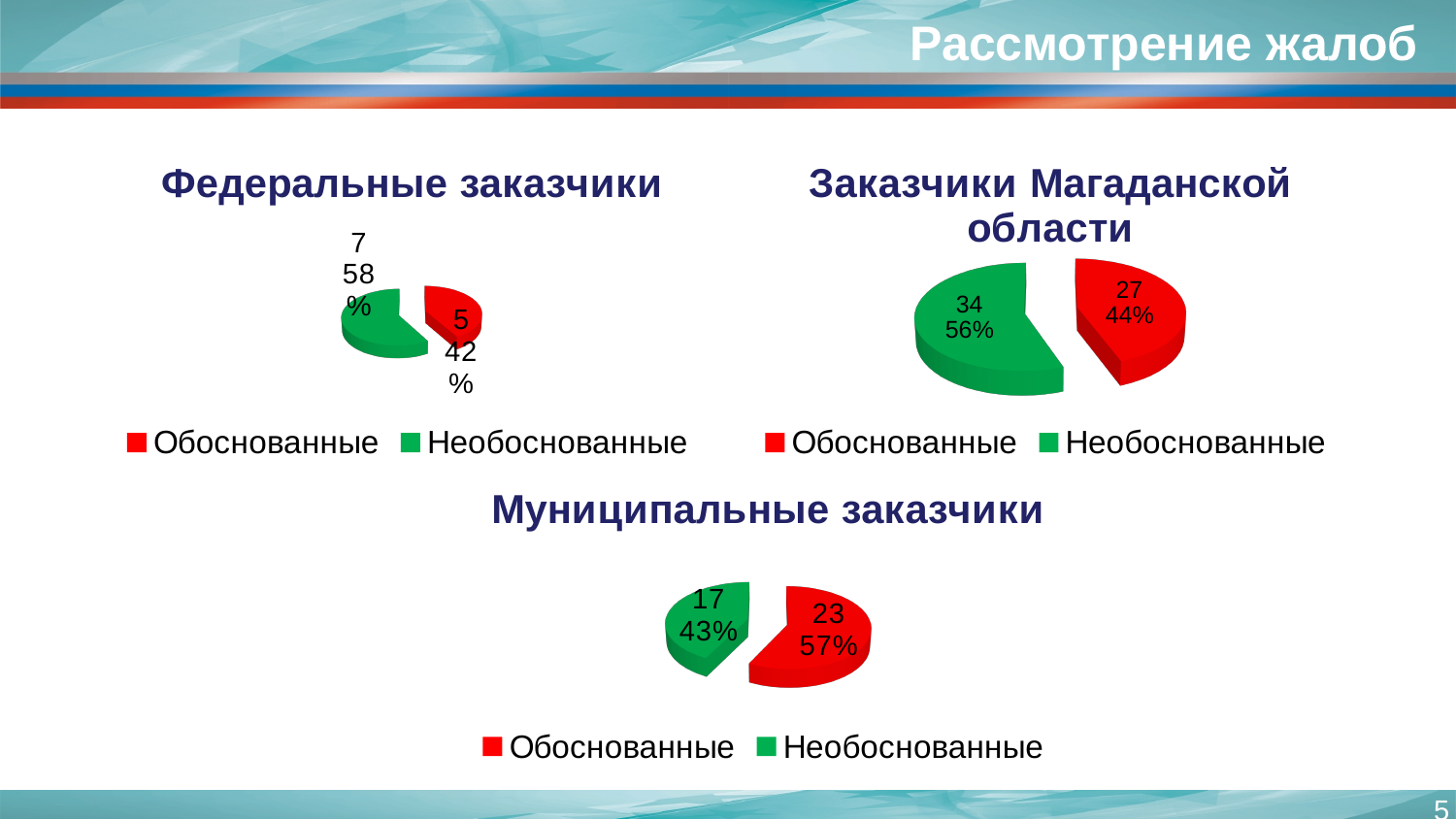
What kind of chart is 'Муниципальные заказчики'? Pie chart In the 'Заказчики Магаданской области' chart, what is the difference between Необоснованные and Обоснованные? 7 In the 'Муниципальные заказчики' chart, what share of the pie is Необоснованные? 43% In the 'Федеральные заказчики' chart, what is the value for Обоснованные? 5 In the 'Заказчики Магаданской области' chart, what share of the pie is Обоснованные? 44% In the 'Федеральные заказчики' chart, which is larger, Обоснованные or Необоснованные? Необоснованные In the 'Заказчики Магаданской области' chart, which category is the smallest? Обоснованные In the 'Федеральные заказчики' chart, what share of the pie is Необоснованные? 58% In the 'Муниципальные заказчики' chart, what is the value for Обоснованные? 23 How many entries does the legend of the 'Федеральные заказчики' chart list? 2 In the 'Заказчики Магаданской области' chart, what is the value for Необоснованные? 34 In the 'Муниципальные заказчики' chart, which category is the largest? Обоснованные